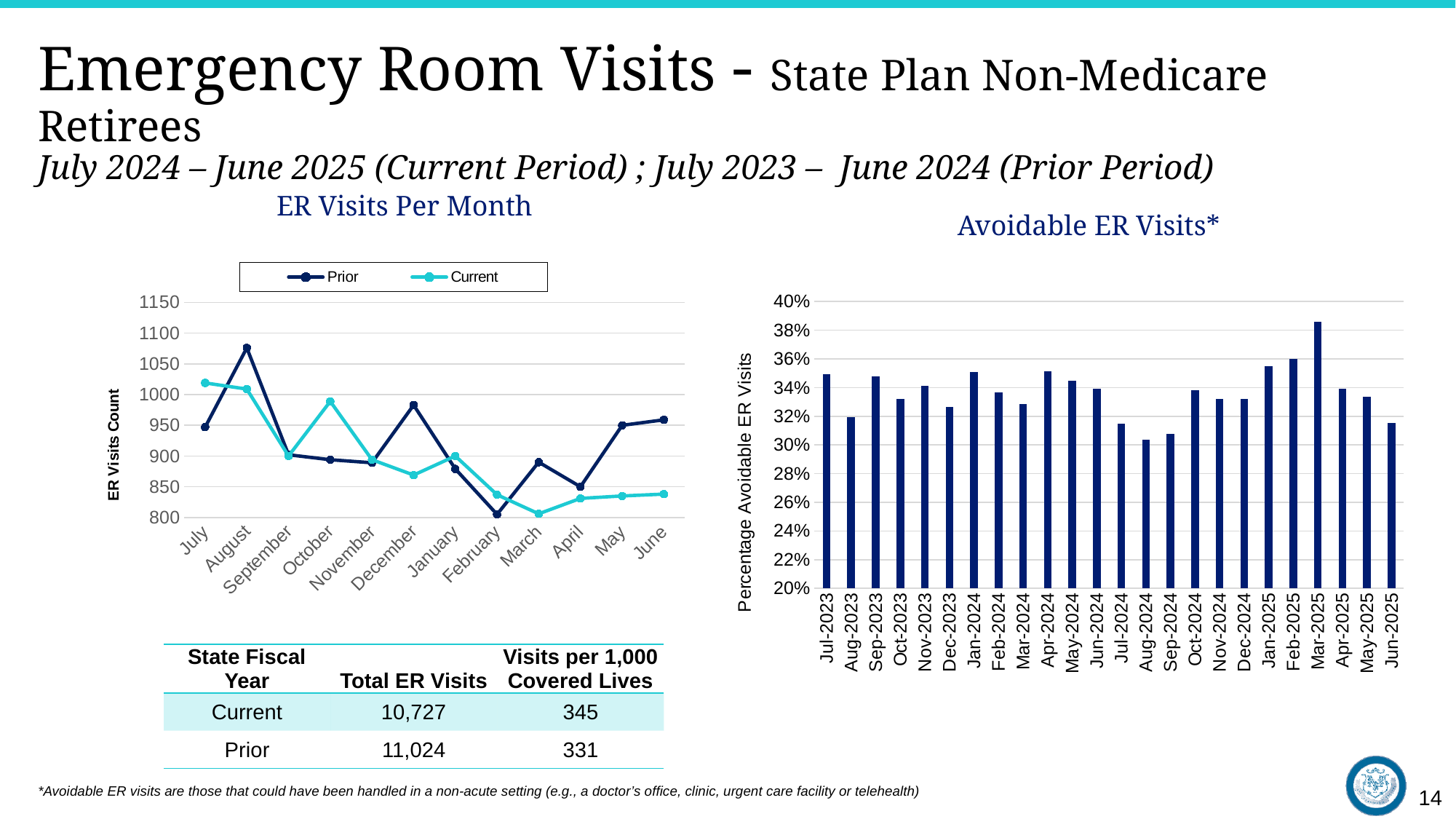
On the Avoidable ER Visits* chart, which month has the highest percentage of avoidable ER visits? Mar-2025 On the ER Visits Per Month chart, how many months are plotted along the x axis? 12 On the ER Visits Per Month chart, is the Prior value for August greater or less than 1050? greater On the Avoidable ER Visits* chart, is the value for Aug-2024 greater or less than 32%? less On the ER Visits Per Month chart, how many series does the legend list? 2 On the ER Visits Per Month chart, in which month is the Prior series highest? August On the ER Visits Per Month chart, what kind of chart is it? line chart On the ER Visits Per Month chart, in December, which series has the higher value, Prior or Current? Prior On the ER Visits Per Month chart, in which month is the Current series highest? July On the Avoidable ER Visits* chart, how many bars are plotted? 24 On the ER Visits Per Month chart, in October, which series has the higher value, Prior or Current? Current On the Avoidable ER Visits* chart, what kind of chart is it? bar chart